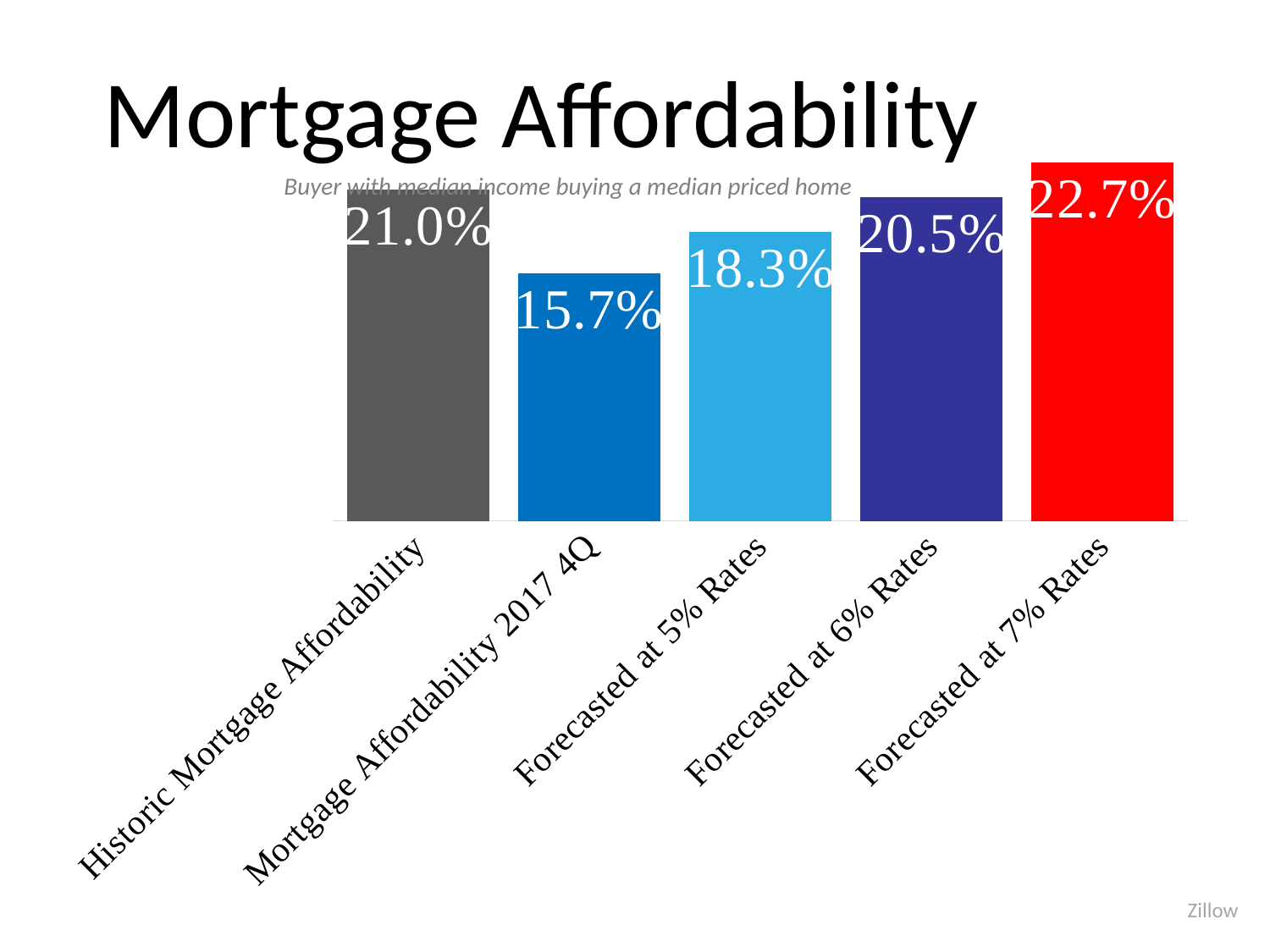
What is the value for Forecasted at 6% Rates? 20.5% What is the value for Historic Mortgage Affordability? 21.0% What kind of chart is shown on the slide? Bar chart What is the value for Forecasted at 5% Rates? 18.3% How many categories are shown in the chart? 5 Which category has the highest value? Forecasted at 7% Rates What is the difference between Forecasted at 7% Rates and Mortgage Affordability 2017 4Q? 7.0% What is the title of the chart? Mortgage Affordability What is the value for Forecasted at 7% Rates? 22.7% What is the value for Mortgage Affordability 2017 4Q? 15.7% Which category has the lowest value? Mortgage Affordability 2017 4Q Which is larger, Historic Mortgage Affordability or Forecasted at 6% Rates? Historic Mortgage Affordability